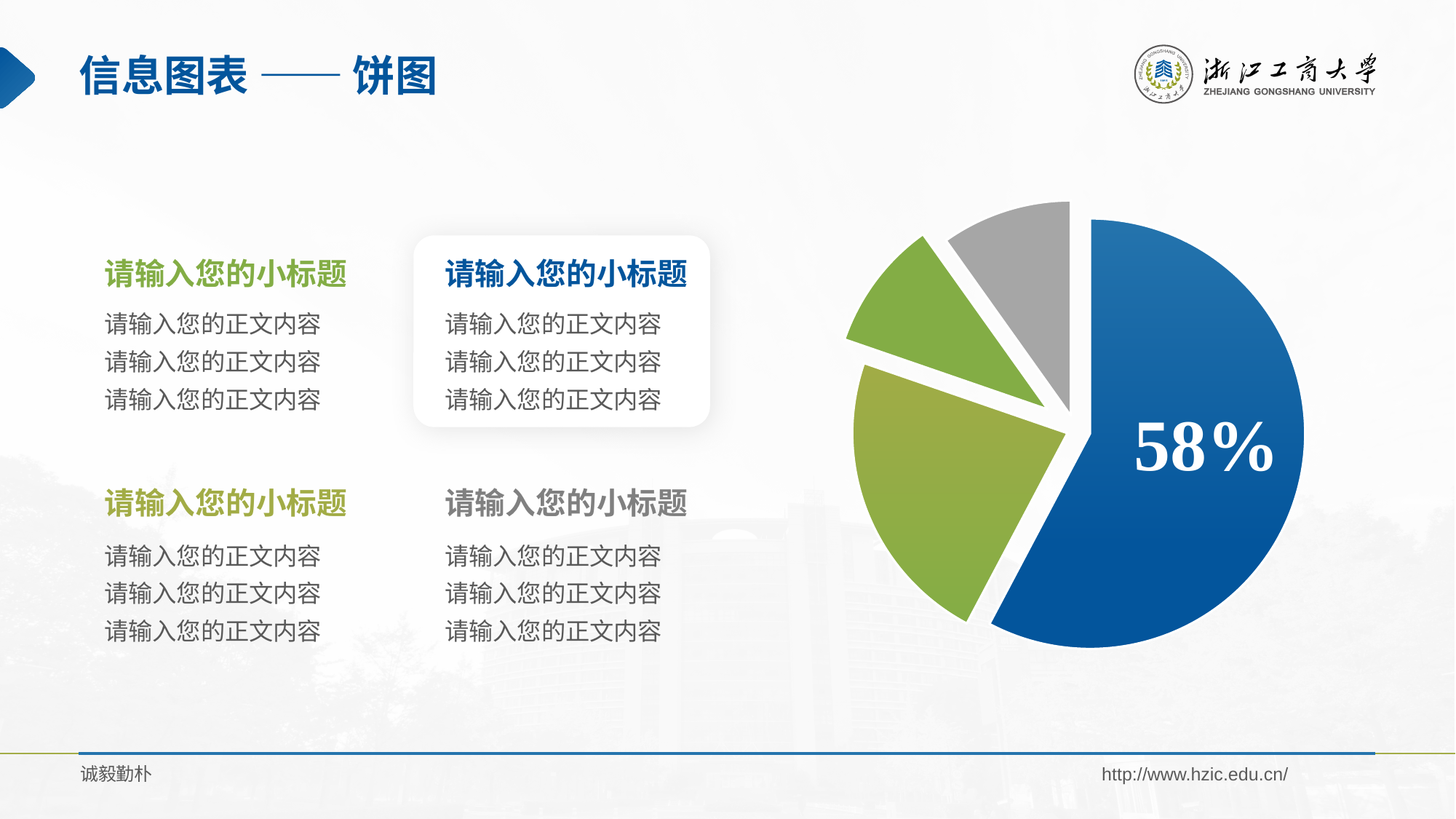
What kind of chart is shown on the slide? pie chart What colour is the slice labelled 58%? blue What is the title of the slide containing the pie chart? 信息图表 —— 饼图 Which is larger, the blue slice or the gray slice? the blue slice What share of the pie does the blue slice represent? 58% Which is larger, the blue slice or the olive green slice? the blue slice What percentage is printed on the blue slice of the pie chart? 58% How many slices does the pie chart have? 4 Which slice of the pie chart is the largest? the blue slice